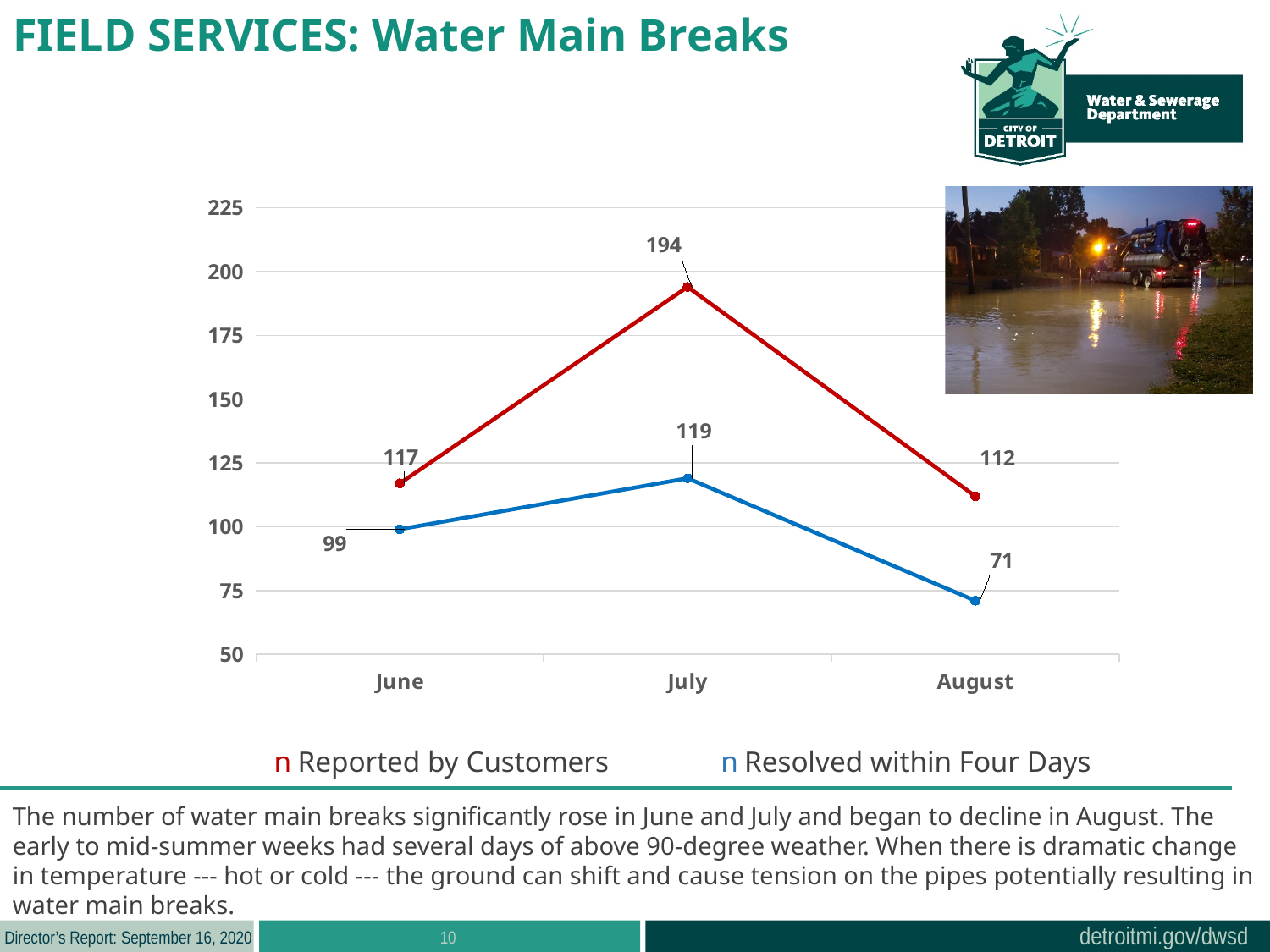
How many months are shown on the x axis? 3 Which is larger: breaks reported by customers in August or breaks resolved within four days in June? Reported by Customers in August Is the value for Resolved within Four Days in July greater or less than 100? greater How many water main breaks were reported by customers in July? 194 What is the difference between breaks reported by customers and breaks resolved within four days in July? 75 What kind of chart is shown on the slide? Line chart What is the value for Reported by Customers in June? 117 How many series does the legend list? 2 In which month was the number of breaks reported by customers highest? July In which month was the number of breaks resolved within four days lowest? August How many water main breaks were resolved within four days in August? 71 Which colour is used for the Resolved within Four Days series? Blue